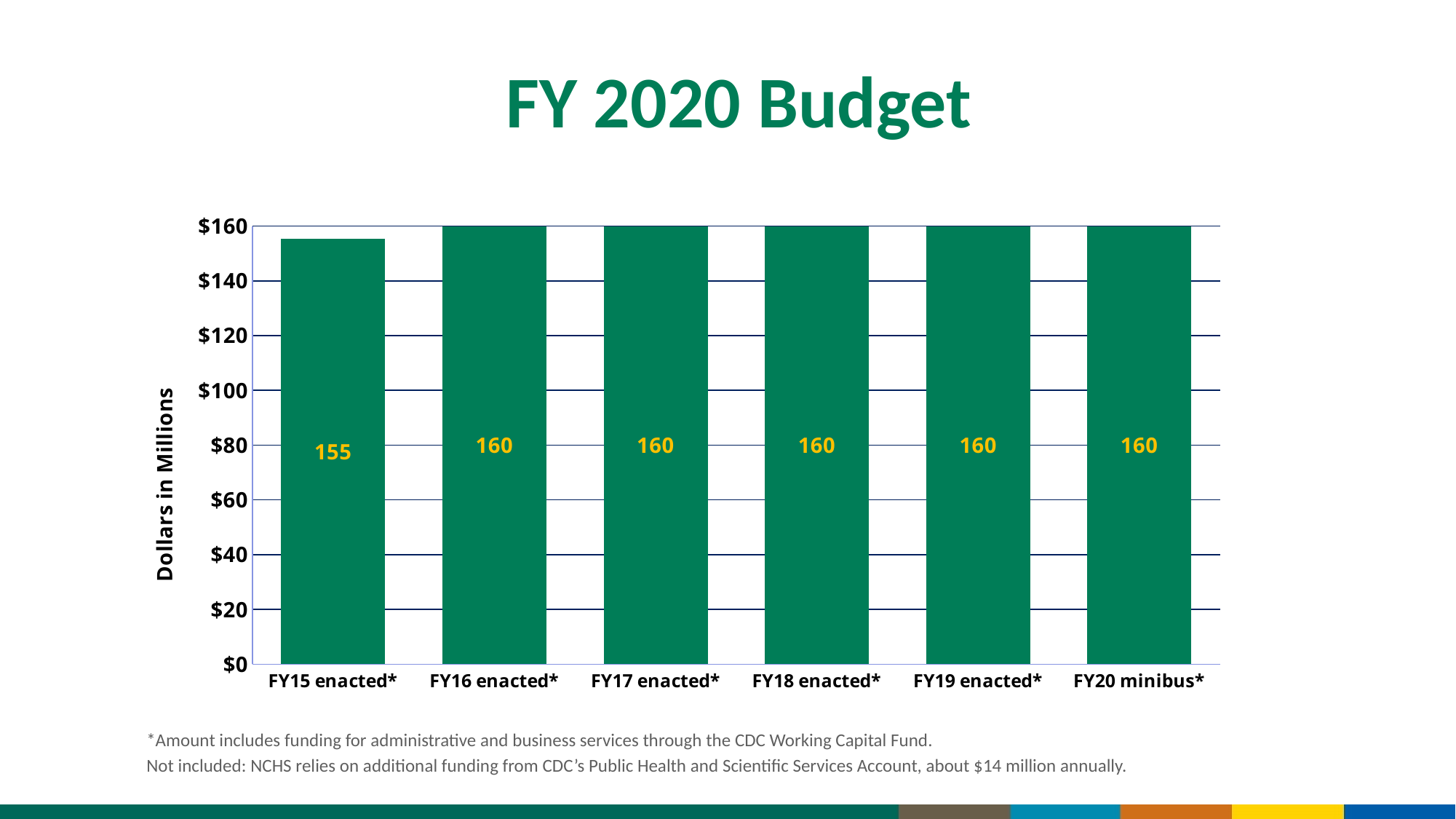
Which is larger, the value for FY15 enacted* or the value for FY17 enacted*? FY17 enacted* How many categories are shown on the x axis? 6 What is the value for FY18 enacted*? 160 What is the value for FY15 enacted*? 155 Do the values rise or fall from FY15 enacted* to FY16 enacted*? rise What kind of chart is shown on the slide? bar chart What is the label of the y axis? Dollars in Millions Is the value for FY15 enacted* greater or less than 140? greater What is the difference between the values for FY16 enacted* and FY15 enacted*? 5 What is the value for FY20 minibus*? 160 Which category has the lowest value? FY15 enacted* What is the title of the slide? FY 2020 Budget